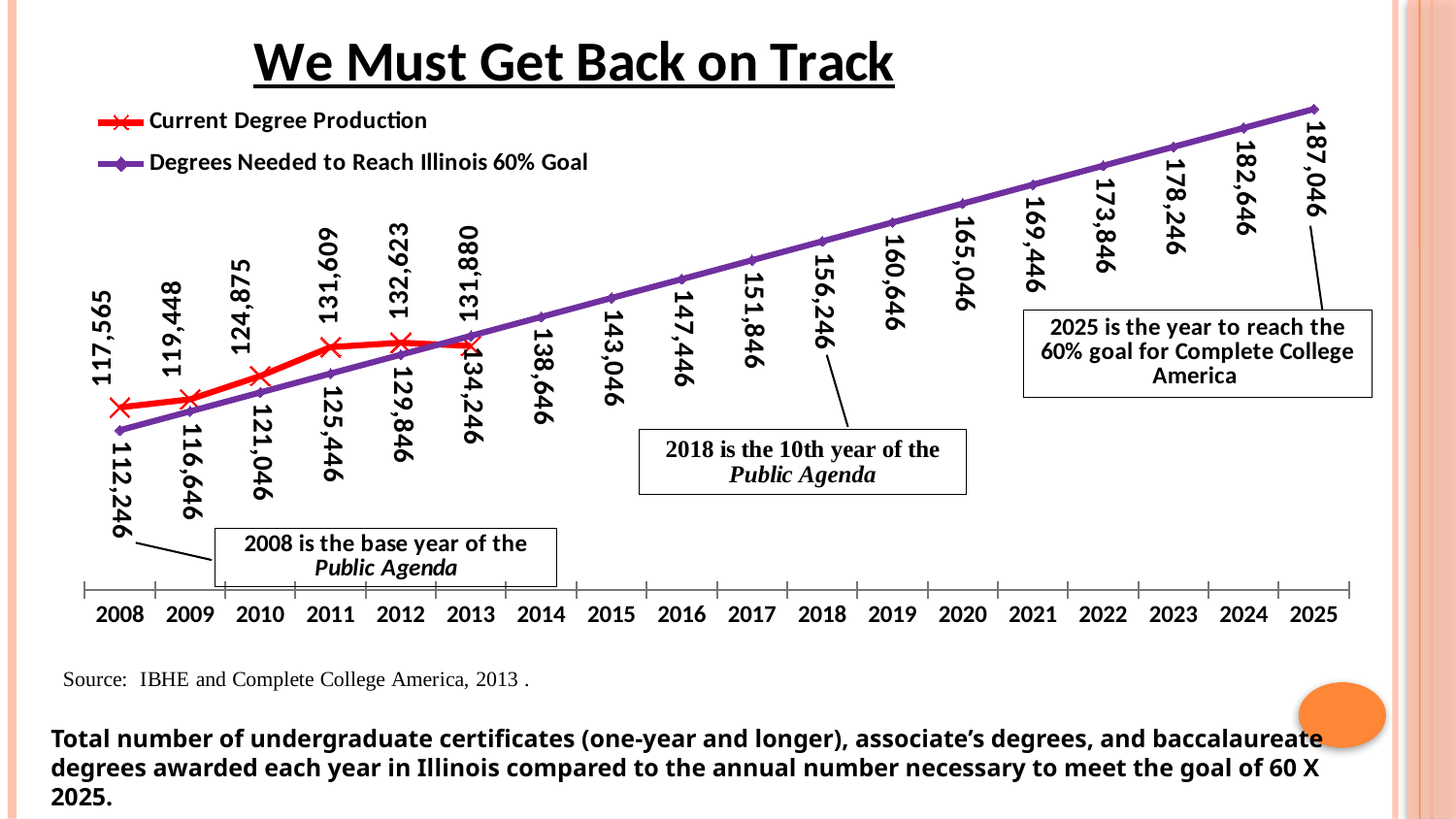
In 2013, which series has the larger value: Current Degree Production or Degrees Needed to Reach Illinois 60% Goal? Degrees Needed to Reach Illinois 60% Goal What is the Degrees Needed to Reach Illinois 60% Goal value for 2018? 156,246 What is the Current Degree Production value for 2011? 131,609 How many degrees are needed to reach the Illinois 60% goal in 2025? 187,046 How many years are shown on the x axis? 18 In which year is Current Degree Production highest? 2012 How many series does the legend list? 2 What kind of chart is shown on the slide? line chart In 2008, how much higher is Current Degree Production than Degrees Needed to Reach Illinois 60% Goal? 5,319 In 2013, what is the difference between Degrees Needed to Reach Illinois 60% Goal and Current Degree Production? 2,366 Does the Degrees Needed to Reach Illinois 60% Goal series rise or fall from 2008 to 2025? rises What is the Current Degree Production value for 2008? 117,565